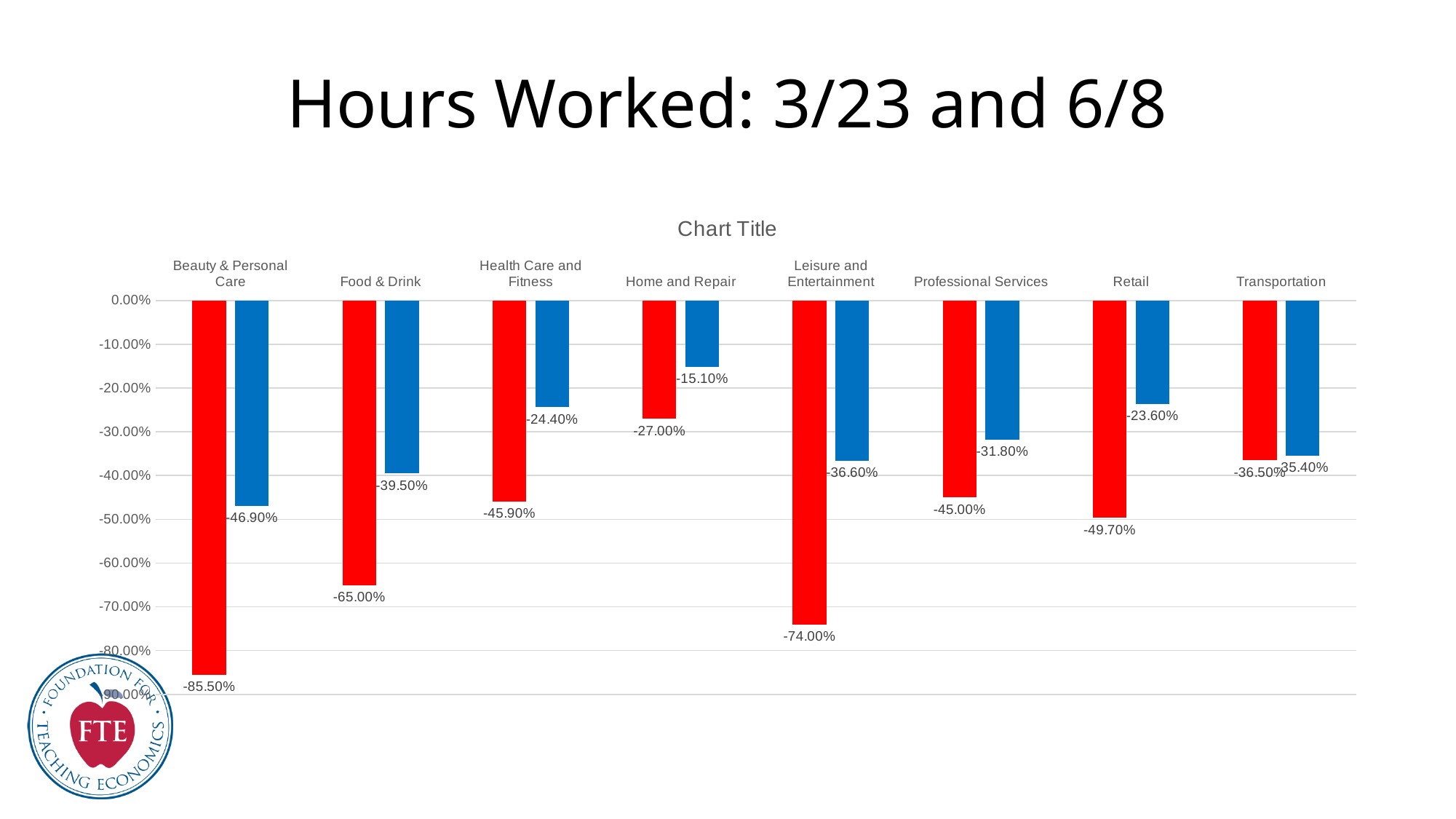
What is the title printed above the chart area? Chart Title Which is larger, the red bar value for Professional Services or the red bar value for Retail? Professional Services (-45.00%) How many categories are shown on the x axis? 8 Which category has the lowest (most negative) red bar value? Beauty & Personal Care What is the difference between the red and blue bar values for Food & Drink? 25.50 percentage points What is the value of the red bar for Beauty & Personal Care? -85.50% What two colours are used for the bars in the chart? Red and blue What is the value of the blue bar for Retail? -23.60% What is the value of the blue bar for Home and Repair? -15.10% What is the value of the red bar for Leisure and Entertainment? -74.00% Which category has the highest (least negative) blue bar value? Home and Repair What kind of chart is shown on the slide? Bar chart